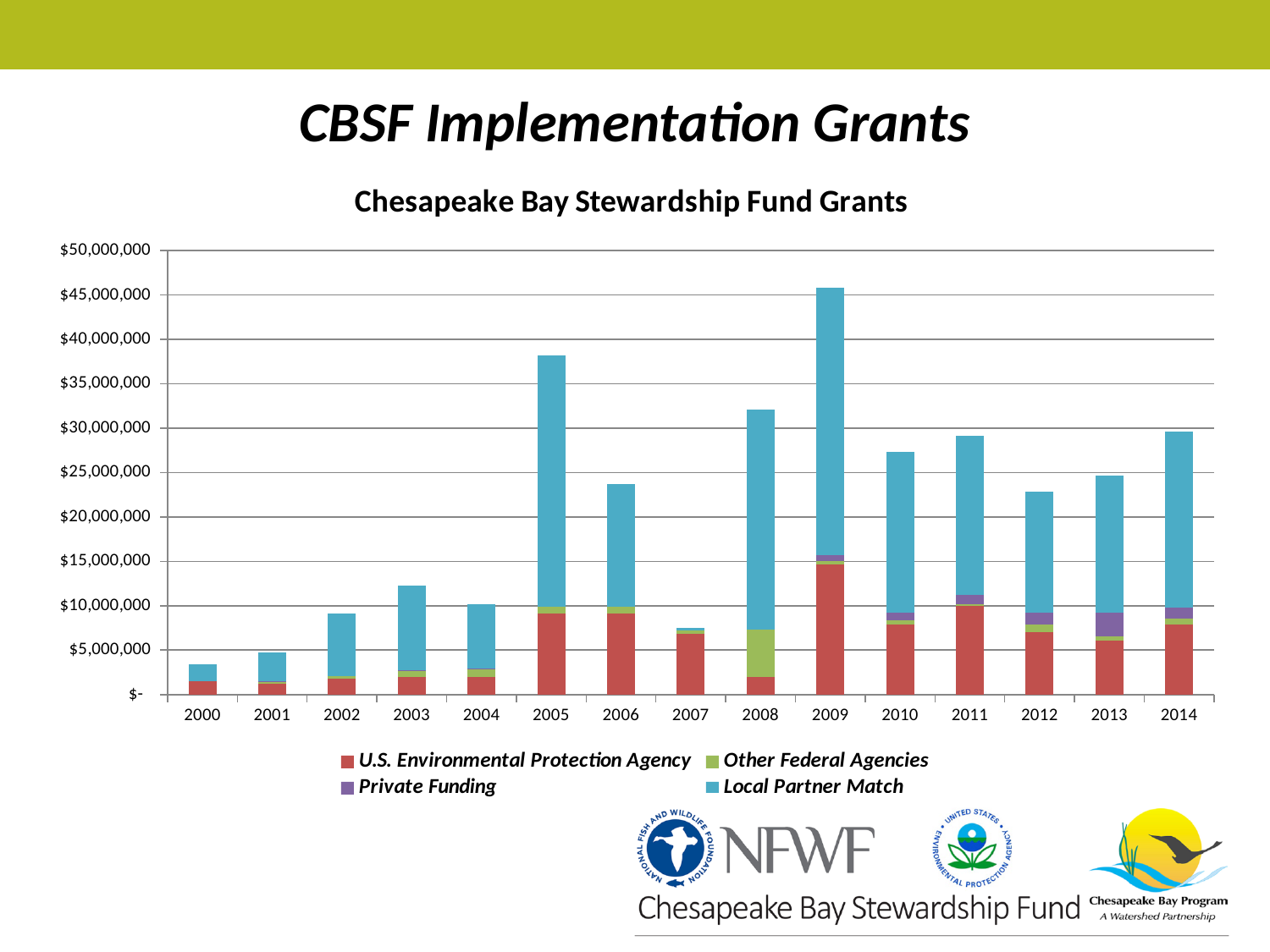
Is the total value for 2007 greater or less than $10,000,000? less How many years are shown on the x axis? 15 Which year has the lowest total grant amount? 2000 How many series does the legend list? 4 Is the total value for 2005 greater or less than $35,000,000? greater Which year has the larger total, 2005 or 2006? 2005 Which year has the larger total, 2010 or 2012? 2010 Is the total value for 2000 greater or less than $5,000,000? less Do the total grant amounts rise or fall from 2000 to 2003? rise Which year has the highest total grant amount? 2009 What kind of chart is shown on the slide? Stacked bar chart What is the title of the chart? Chesapeake Bay Stewardship Fund Grants